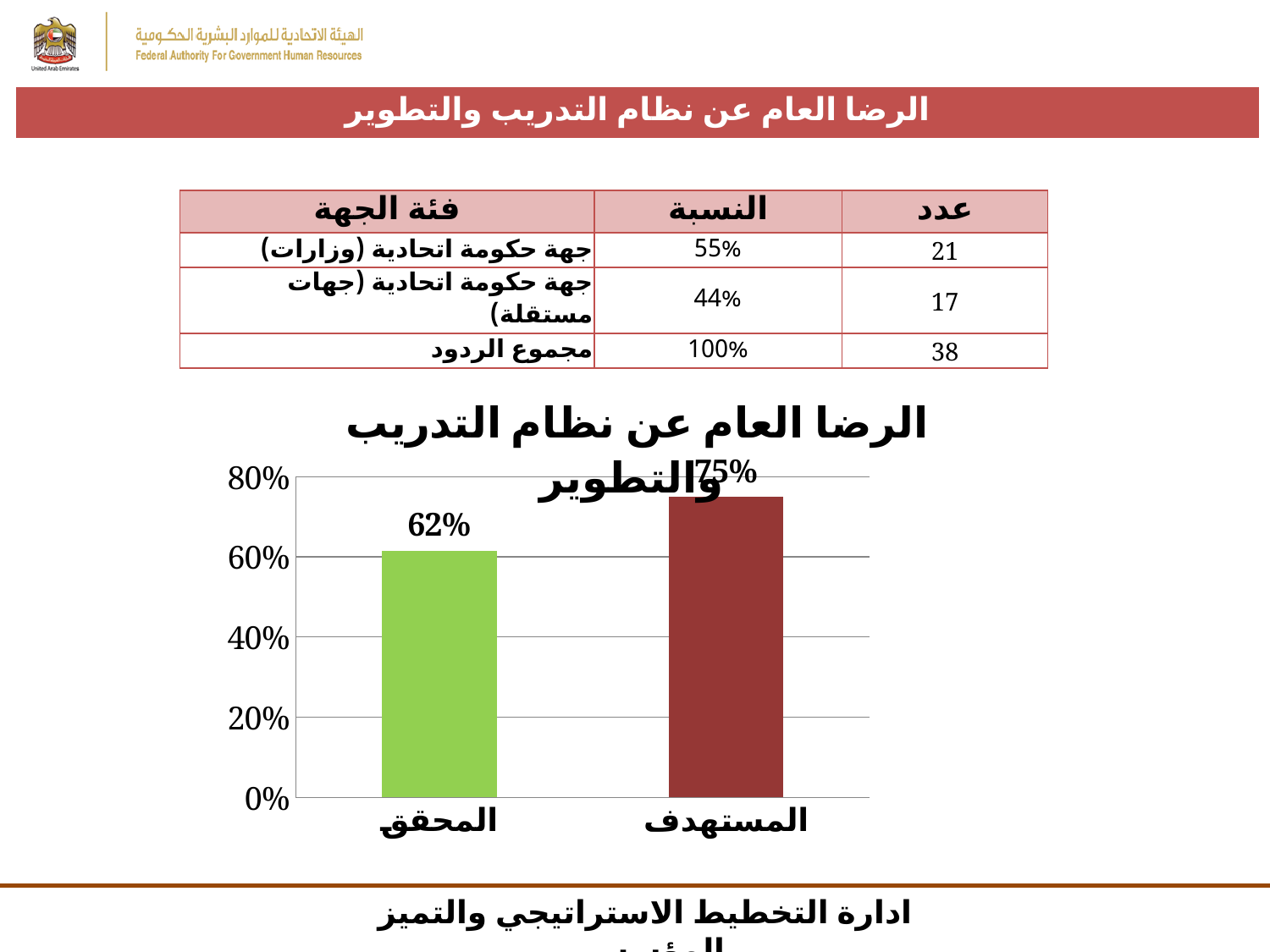
Which category has the highest value in the chart? المستهدف What is the value for المستهدف in the chart? 75% What is the difference between the values for المستهدف and المحقق? 13% Which category has the lowest value in the chart? المحقق What is the title of the chart? الرضا العام عن نظام التدريب والتطوير Which is larger, the value for المحقق or the value for المستهدف? المستهدف What is the value for المحقق in the chart? 62% What colour is the bar for المحقق? green Is the value for المحقق greater or less than 60%? greater What kind of chart is shown on the slide? bar chart Is the value for المستهدف greater or less than 80%? less How many bars are plotted in the chart? 2